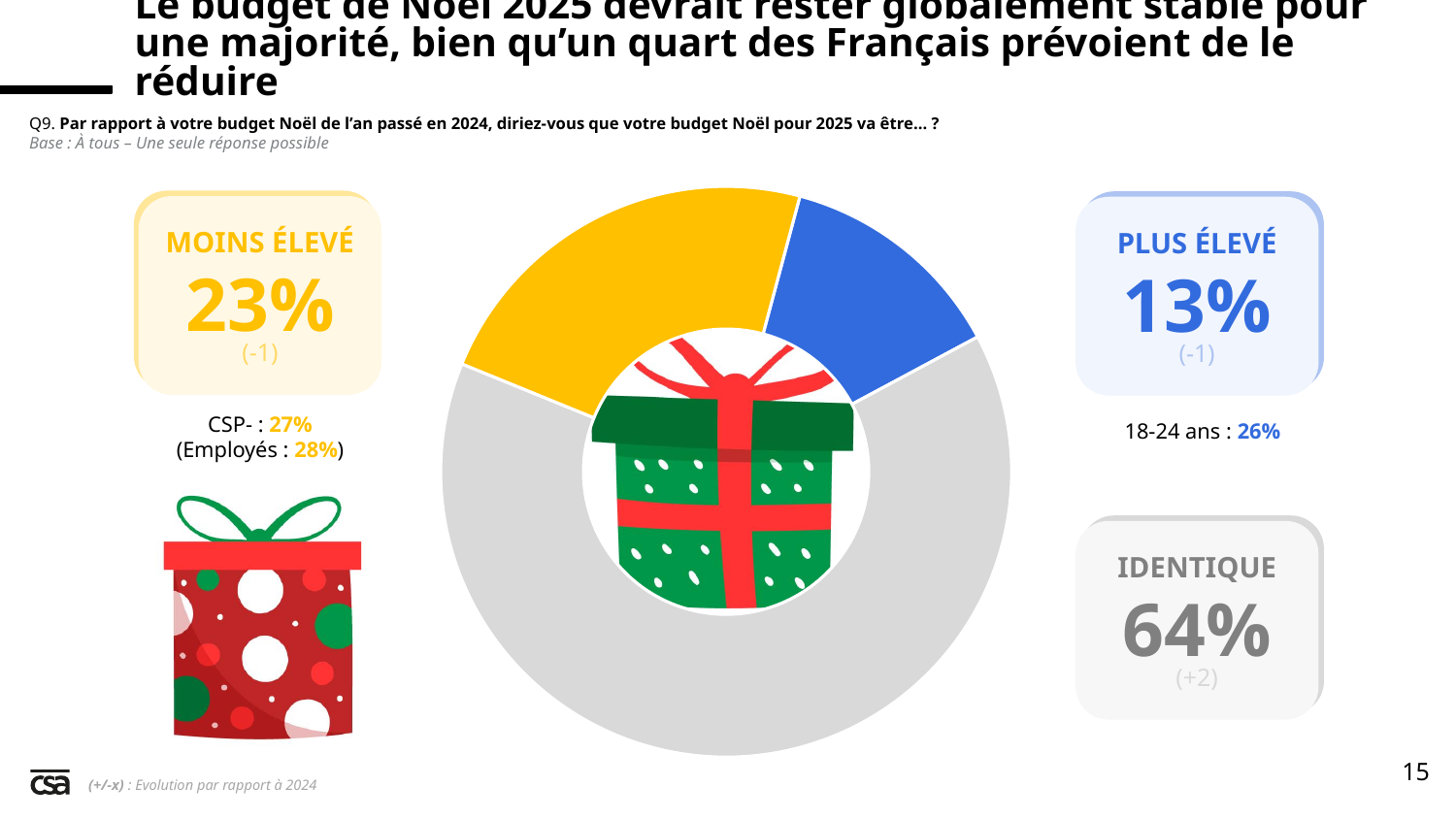
What is the difference in percentage points between "Identique" and "Moins élevé"? 41 points What share of respondents say their 2025 Christmas budget will be "Identique"? 64% What share of respondents say their 2025 Christmas budget will be "Moins élevé"? 23% What is the evolution compared to 2024 shown for "Identique"? +2 How many categories are shown in the donut chart? 3 What percentage of 18-24 year olds expect a higher ("Plus élevé") Christmas budget? 26% What share of respondents say their 2025 Christmas budget will be "Plus élevé"? 13% Which colour represents the "Moins élevé" segment in the donut chart? Yellow Which is larger, the share for "Moins élevé" or the share for "Plus élevé"? Moins élevé What kind of chart is shown on the slide? Donut (pie) chart Which category has the largest share of the donut chart? Identique Which category has the smallest share of the donut chart? Plus élevé